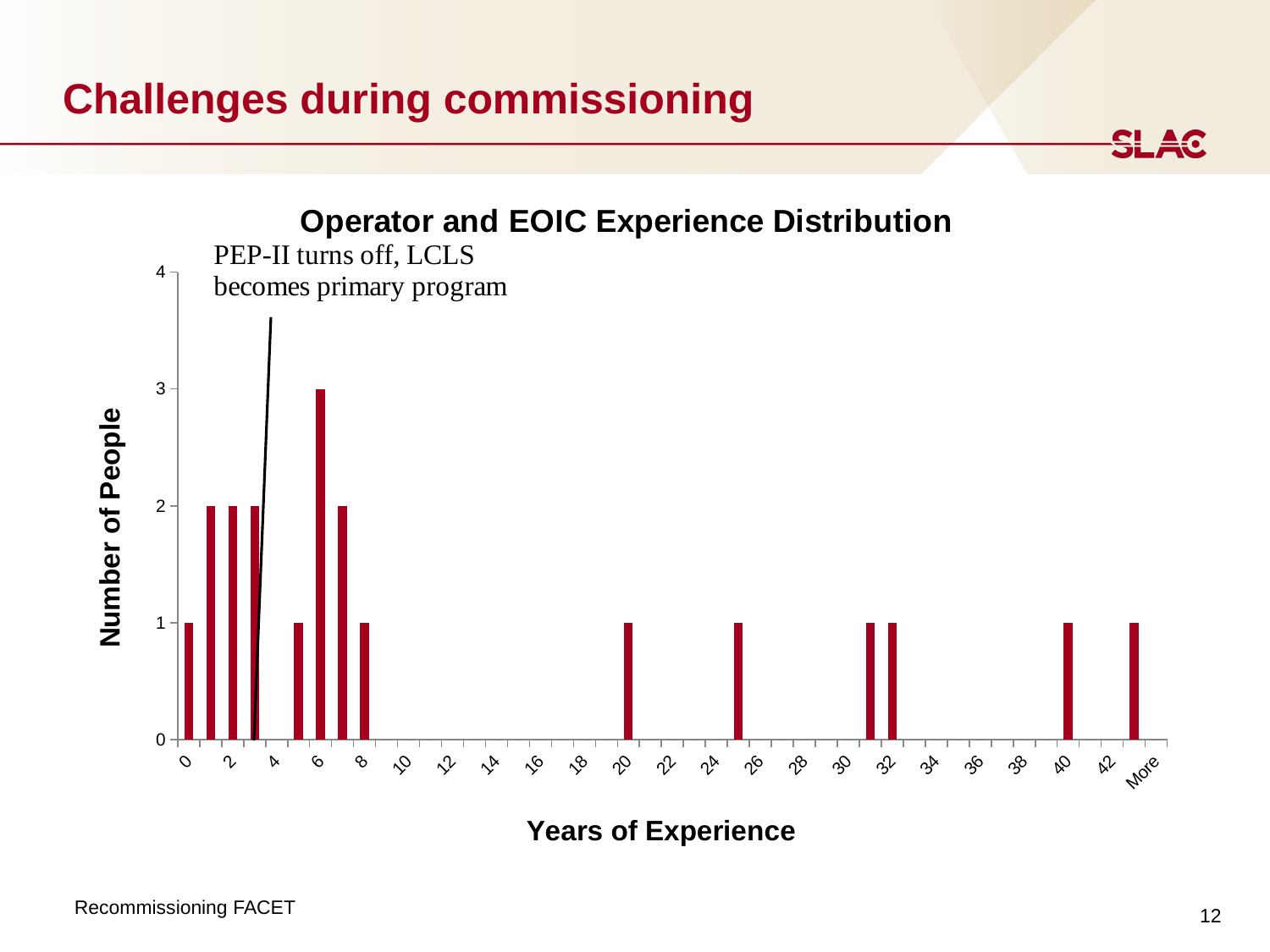
Is the number of people with 6 years of experience greater or less than 2? greater Which years-of-experience category has the highest number of people? 6 How many people have 0 years of experience? 1 What is the label of the vertical axis? Number of People Which has more people: 6 years of experience or 8 years of experience? 6 years How many people have 20 years of experience? 1 What is the title of the chart? Operator and EOIC Experience Distribution How many people have 6 years of experience? 3 How many people have 2 years of experience? 2 What is the difference between the number of people with 6 years of experience and the number with 2 years of experience? 1 How many people have 40 years of experience? 1 What type of chart is shown on the slide? bar chart